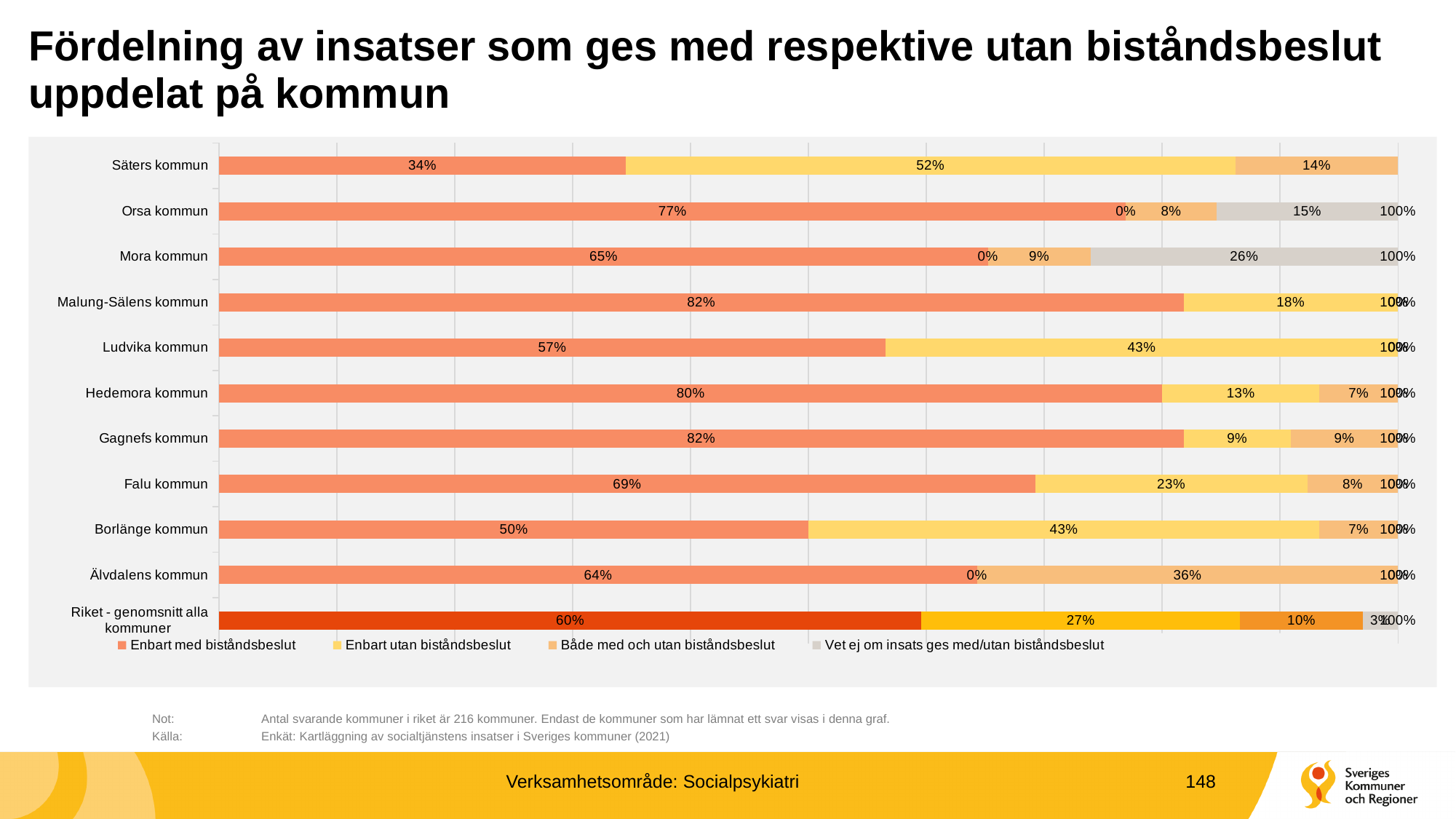
What share of insatser in Älvdalens kommun is given 'Både med och utan biståndsbeslut'? 36% What kind of chart is shown on the slide? Stacked bar chart Which has a larger 'Enbart med biståndsbeslut' share, Orsa kommun or Mora kommun? Orsa kommun What share of insatser in Säters kommun is given 'Enbart med biståndsbeslut'? 34% How many series does the legend list? 4 How many percentage points higher is the 'Enbart med biståndsbeslut' share for Falu kommun than for Borlänge kommun? 19 percentage points How many kommun categories (including Riket) are shown in the chart? 11 What is the value for 'Vet ej om insats ges med/utan biståndsbeslut' for Mora kommun? 26% Which kommun has the lowest share of 'Enbart med biståndsbeslut'? Säters kommun Which kommun has the highest share of 'Enbart utan biståndsbeslut'? Säters kommun What is the 'Enbart utan biståndsbeslut' value for Riket - genomsnitt alla kommuner? 27% Which legend entry is shown in grey? Vet ej om insats ges med/utan biståndsbeslut